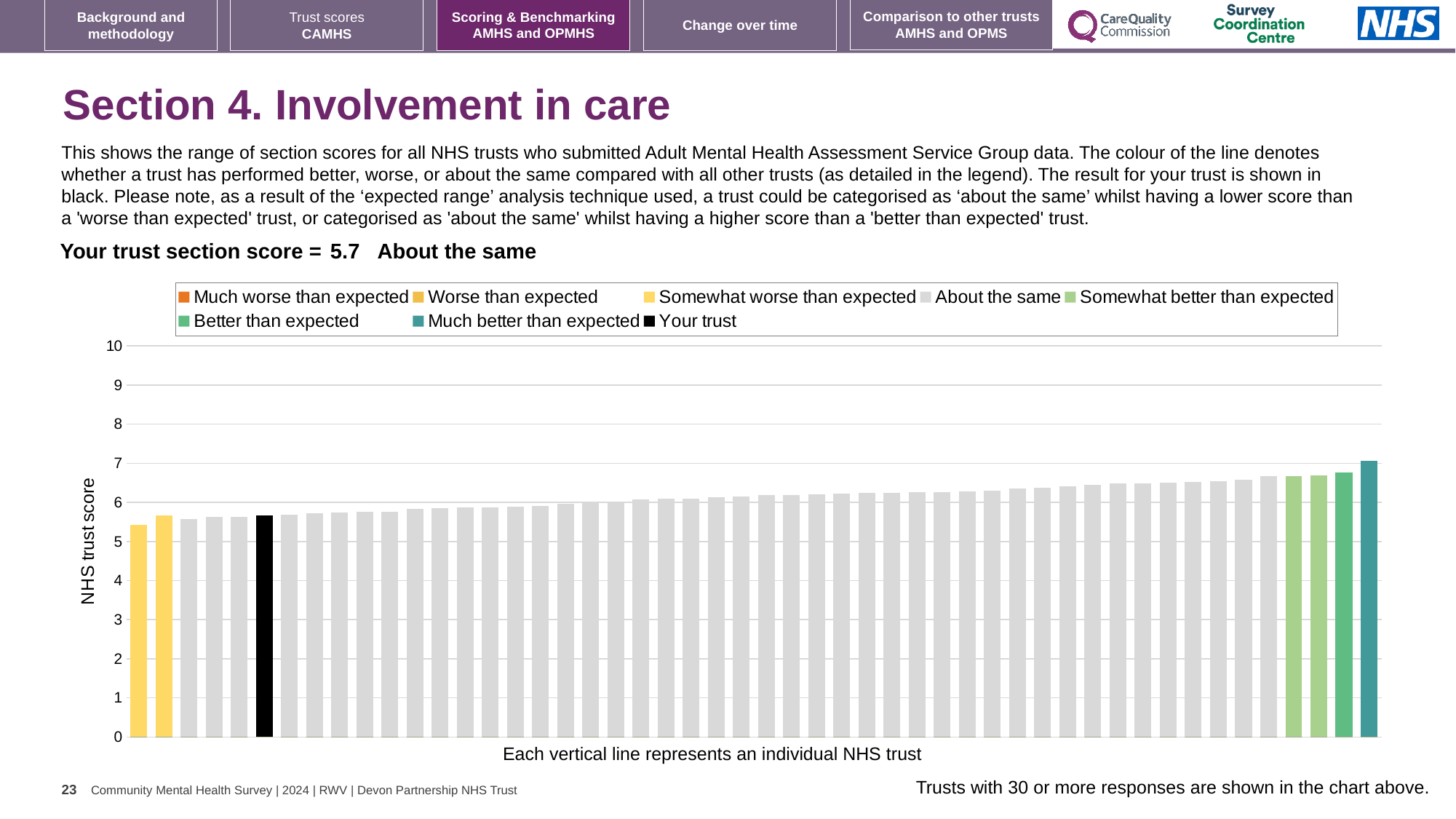
What kind of chart is shown on the slide? bar chart What is the section score for your trust? 5.7 How many entries does the chart legend list? 8 Is the value of the tallest bar greater or less than 6? greater Which legend category does the shortest bar belong to? Somewhat worse than expected How many bars are coloured as 'Worse than expected'? 0 Do the bar values rise or fall from left to right along the x axis? rise What is the title of the vertical axis? NHS trust score Is the value of the shortest bar greater or less than 6? less Which legend category is your trust placed in? About the same Is the value for your trust greater or less than 5? greater Which legend category does the tallest bar belong to? Much better than expected